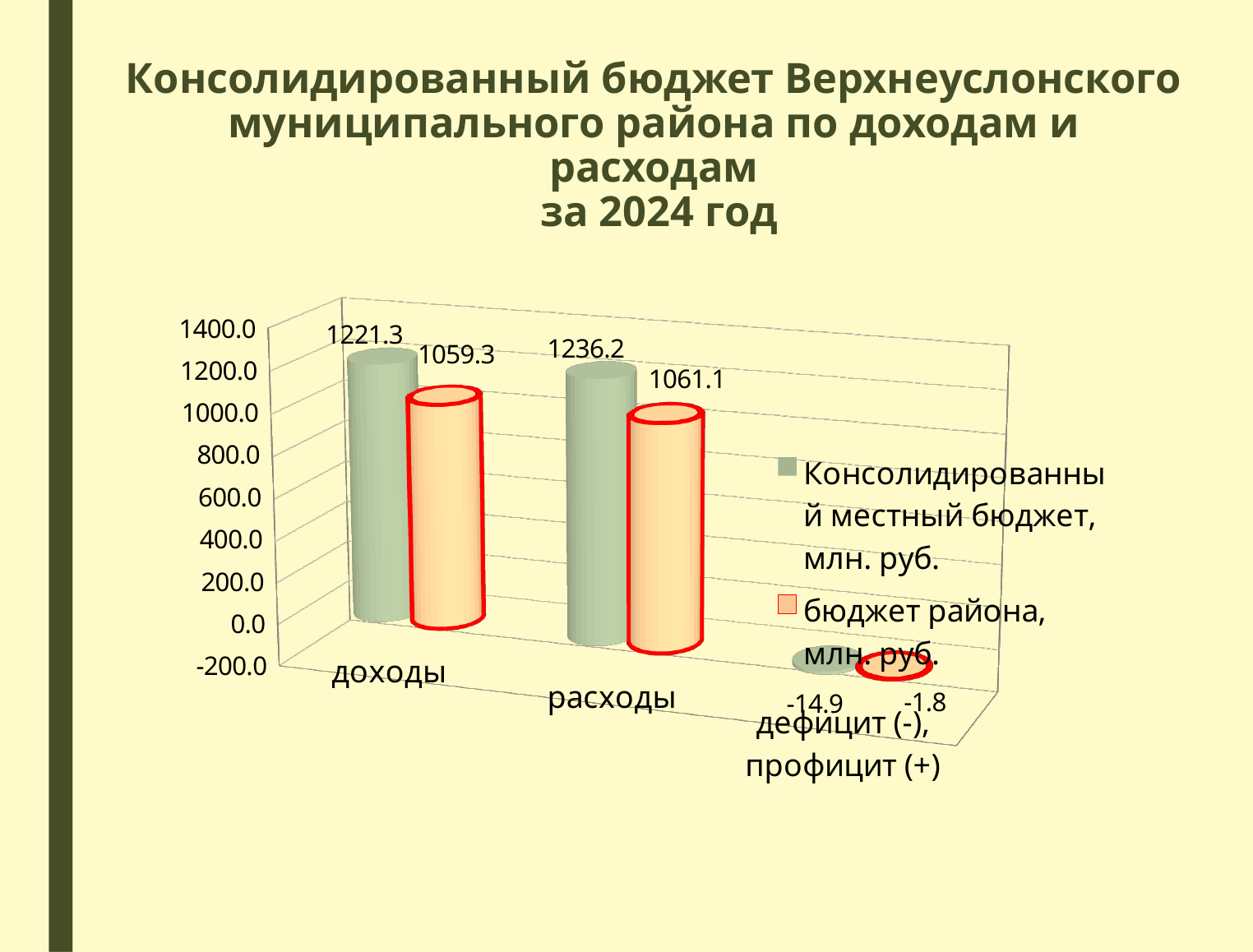
How many series does the legend list? 2 What is the value of the consolidated local budget for дефицит (-), профицит (+)? -14.9 Which is larger for расходы: the consolidated local budget or бюджет района? Консолидированный местный бюджет What is the value of бюджет района for расходы? 1061.1 What kind of chart is shown on the slide? bar chart Is the value of бюджет района for доходы greater or less than 1000.0? greater What is the difference between the consolidated local budget values for расходы and доходы? 14.9 Which category has the lowest value for the бюджет района series? дефицит (-), профицит (+) What is the value of the consolidated local budget (Консолидированный местный бюджет) for доходы? 1221.3 What is the value of бюджет района for доходы? 1059.3 How many categories are shown on the x axis? 3 Which category has the highest value for the consolidated local budget series? расходы